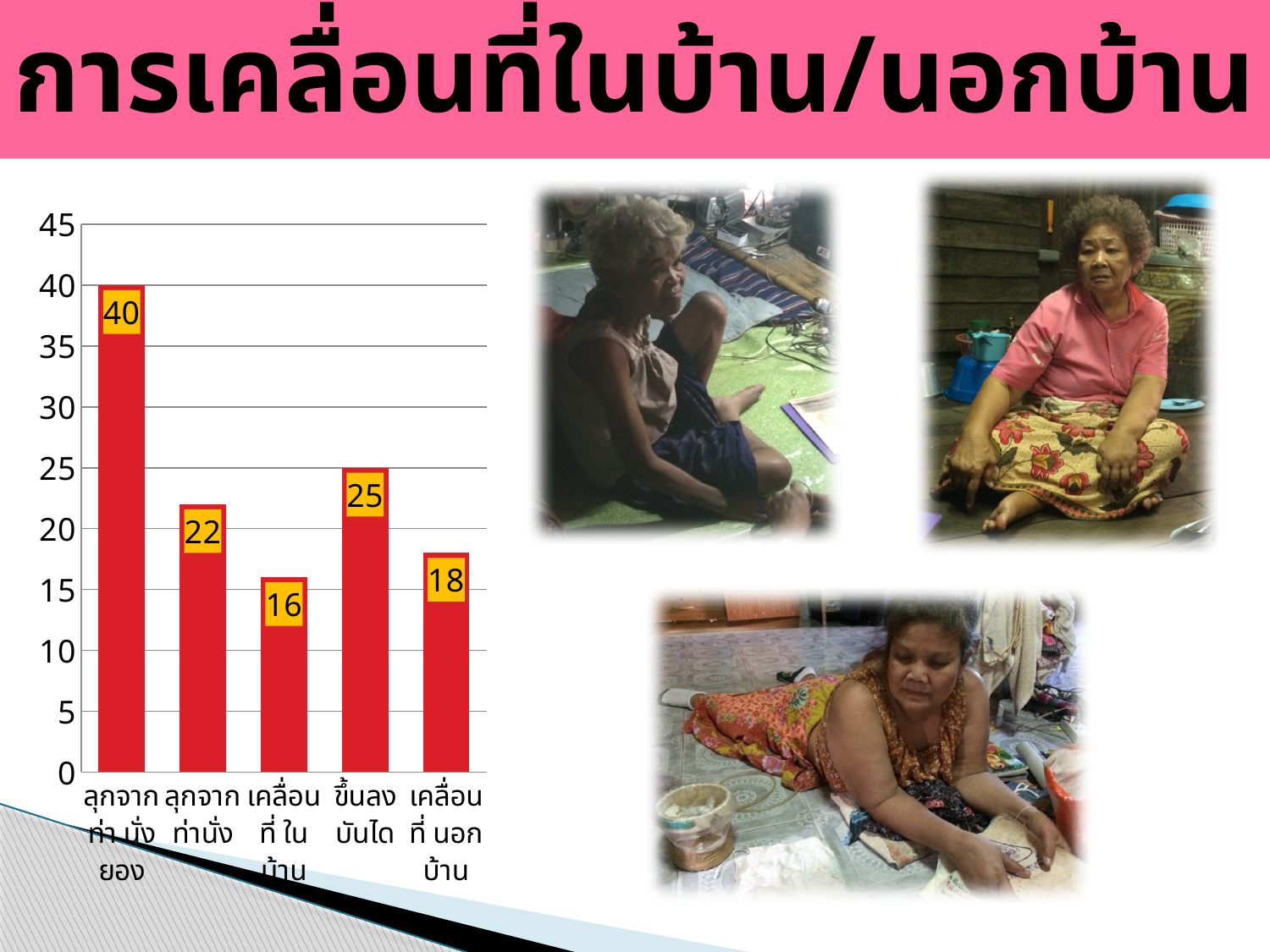
Which category has the highest value? ลุกจากท่านั่งยอง Which is larger, the value for ขึ้นลงบันได or the value for ลุกจากท่านั่ง? ขึ้นลงบันได Which category has the lowest value? เคลื่อนที่ในบ้าน What is the value for เคลื่อนที่ในบ้าน? 16 Is the value for เคลื่อนที่นอกบ้าน greater or less than 20? less What is the value for ขึ้นลงบันได? 25 How many categories are shown in the chart? 5 What is the title of the slide containing the chart? การเคลื่อนที่ในบ้าน/นอกบ้าน What kind of chart is shown on the slide? bar chart What is the value for เคลื่อนที่นอกบ้าน? 18 What is the value for ลุกจากท่านั่งยอง? 40 What is the difference between the values for ลุกจากท่านั่งยอง and ลุกจากท่านั่ง? 18